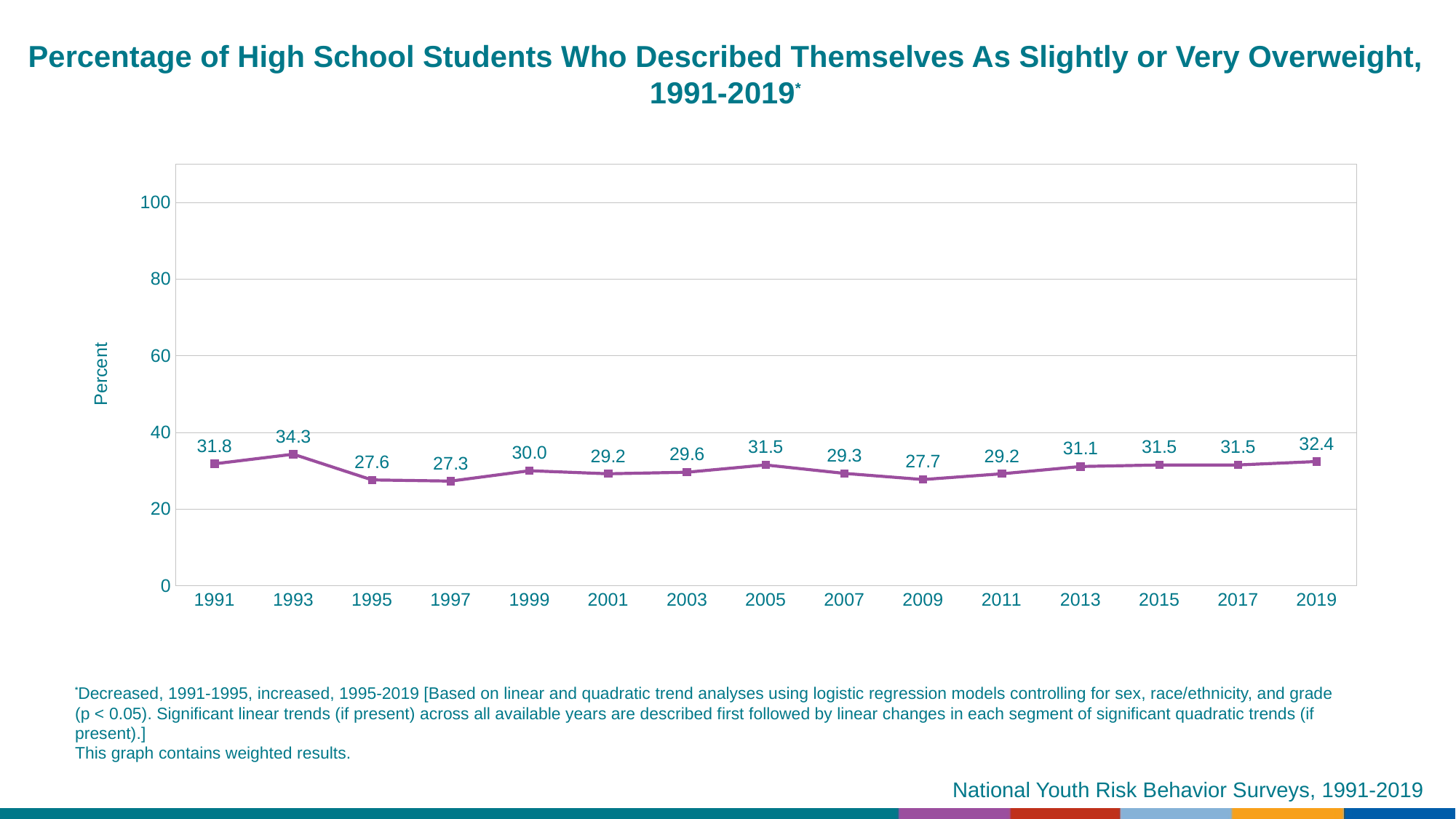
Which year has the lowest percentage? 1997 Is the value for 1993 greater or less than 40? less Which year has a larger value, 2005 or 2007? 2005 What kind of chart is shown on the slide? line chart Which year has the highest percentage? 1993 What is the value plotted for 2009? 27.7 What percentage of high school students described themselves as slightly or very overweight in 1991? 31.8 What is the label on the y axis? Percent What is the value plotted for 2019? 32.4 Did the percentage rise or fall from 1991 to 1995? fall How many years are plotted on the x axis? 15 What is the difference between the values for 1993 and 1997? 7.0